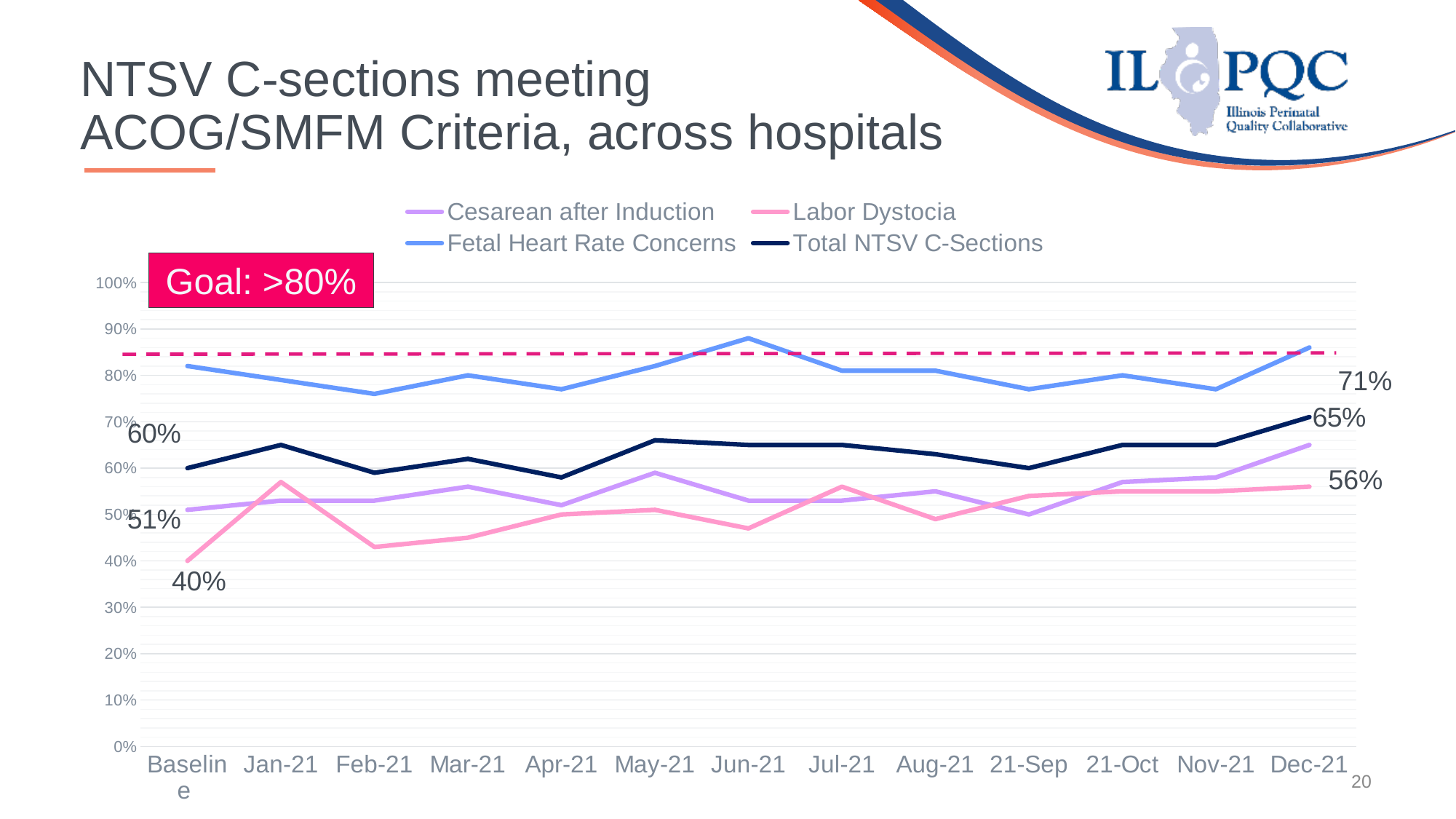
At Baseline, which is higher: Cesarean after Induction or Labor Dystocia? Cesarean after Induction What is the value for Total NTSV C-Sections at Baseline? 60% What is the value for Cesarean after Induction at Dec-21? 65% What type of chart is shown on the slide? line chart What is the value for Labor Dystocia at Baseline? 40% Which series has the highest value at Dec-21? Fetal Heart Rate Concerns What goal is stated in the box on the chart? Goal: >80% Is the value for Fetal Heart Rate Concerns at Jun-21 greater or less than 80%? greater What is the value for Total NTSV C-Sections at Dec-21? 71% How many series does the legend list? 4 By how many percentage points did Labor Dystocia change from Baseline to Dec-21? 16 percentage points How many time points are shown along the x axis? 13